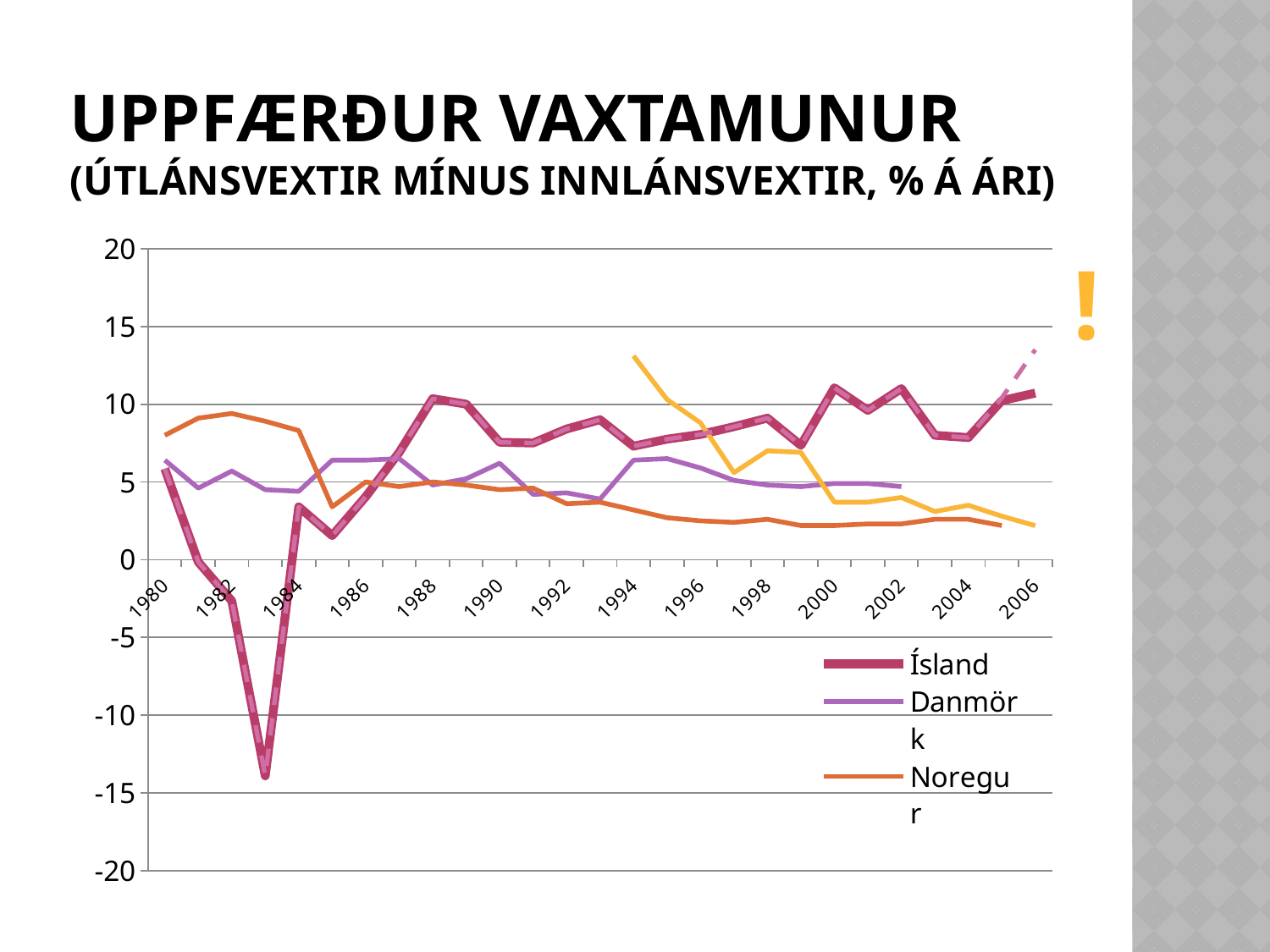
In 2000, which series has the larger value, Ísland or Danmörk? Ísland Is the value for Ísland in 1988 greater or less than 5? greater In 1980, which series has the larger value, Ísland or Noregur? Noregur Does the Ísland line rise or fall between 1983 and 1988? rise What kind of chart is shown on the slide? line chart Is the value for Ísland in 1983 greater or less than -10? less How many series does the legend list? 3 What is the highest value shown on the y axis? 20 Does the Noregur line rise or fall between 1982 and 1985? fall Which series reaches the lowest value on the chart? Ísland Is the value for Danmörk in 1986 greater or less than 5? greater